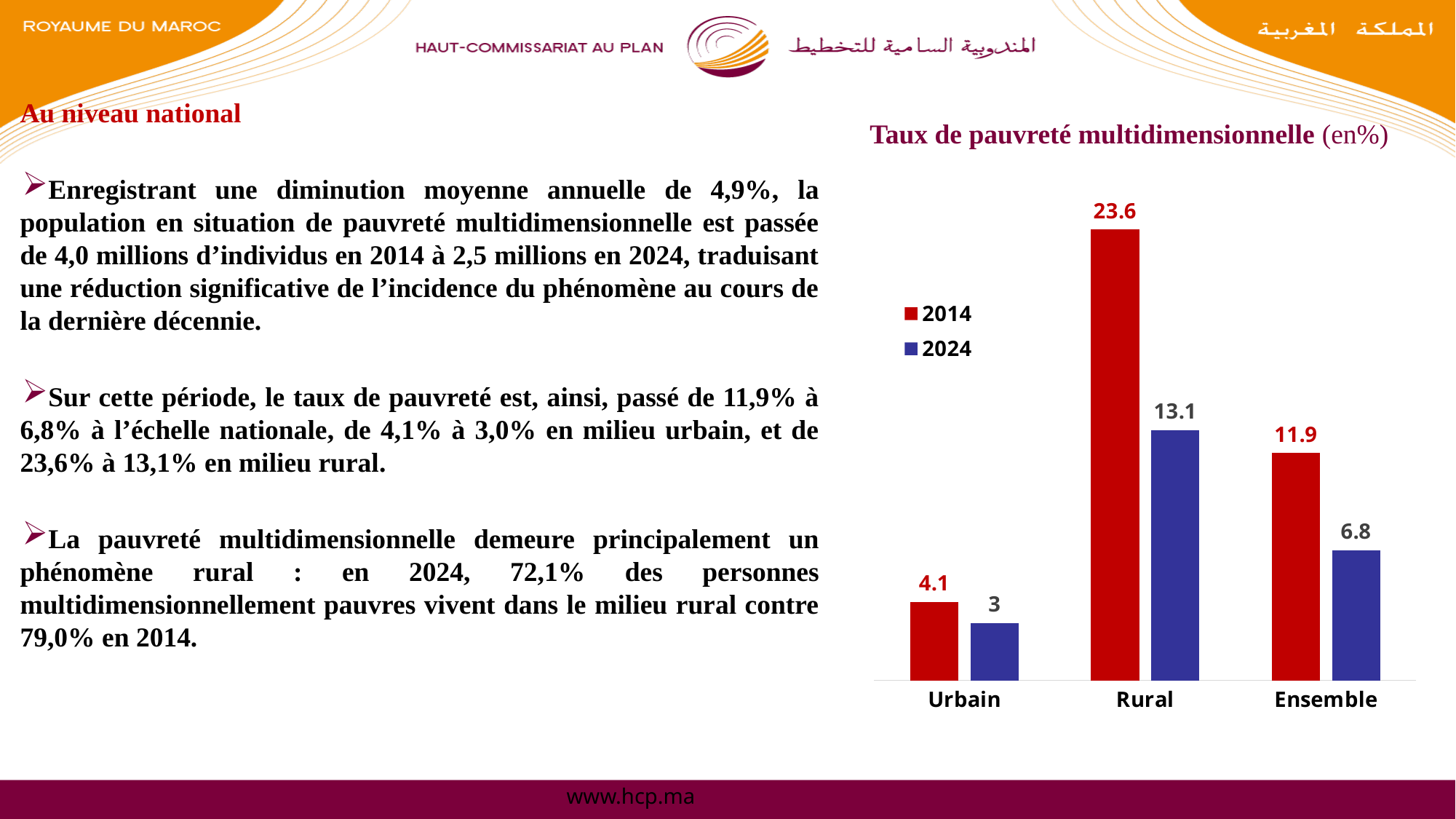
What is the difference between the Ensemble values for 2014 and 2024? 5.1 What is the difference between the Rural values for 2014 and 2024? 10.5 Which category has the highest value in 2014? Rural What kind of chart is shown on the slide? Bar chart What is the value for Ensemble in 2024? 6.8 What is the multidimensional poverty rate for Urbain in 2024? 3 What is the multidimensional poverty rate for Rural in 2014? 23.6 How many series does the legend list? 2 Which category has the lowest value in 2024? Urbain How many categories are shown on the x axis? 3 Which is larger, the Rural value in 2024 or the Ensemble value in 2014? Rural in 2024 Which colour represents the 2024 series? Blue